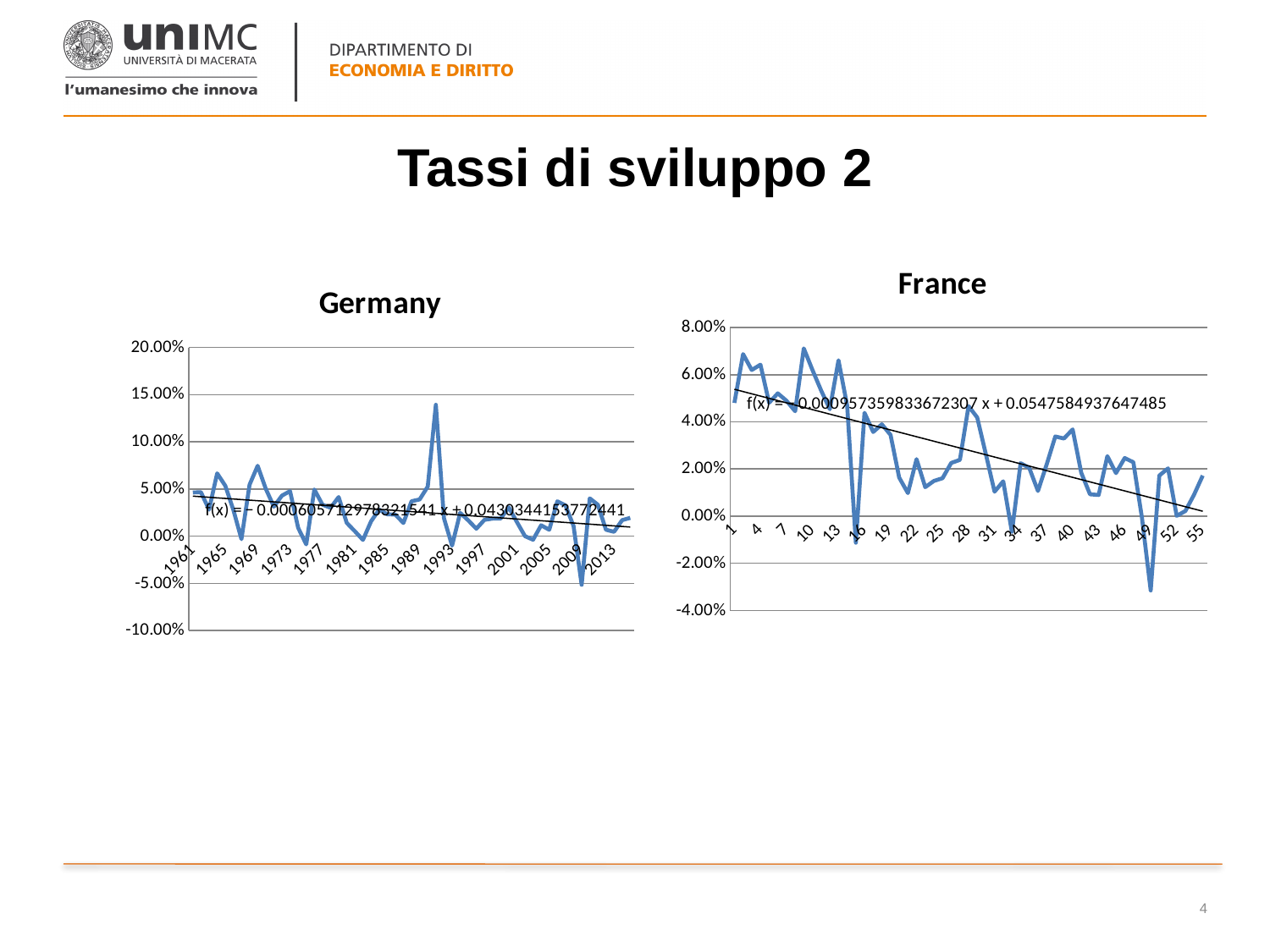
On the France chart, is the highest value of the series greater or less than 6.00%? greater What is the title of the chart on the right of the slide? France What is the title of the chart on the left of the slide? Germany On the Germany chart, does the fitted trendline rise or fall along the x axis? fall What kind of chart is the France chart? line chart On the France chart, what is the intercept (constant term) shown in the trendline equation f(x)? 0.0547584937647485 On the Germany chart, is the highest value of the series greater or less than 10.00%? greater Which chart reaches a higher peak value, Germany or France? Germany On the France chart, does the fitted trendline rise or fall along the x axis? fall What kind of chart is the Germany chart? line chart On the Germany chart, is the lowest value of the series greater or less than 0.00%? less